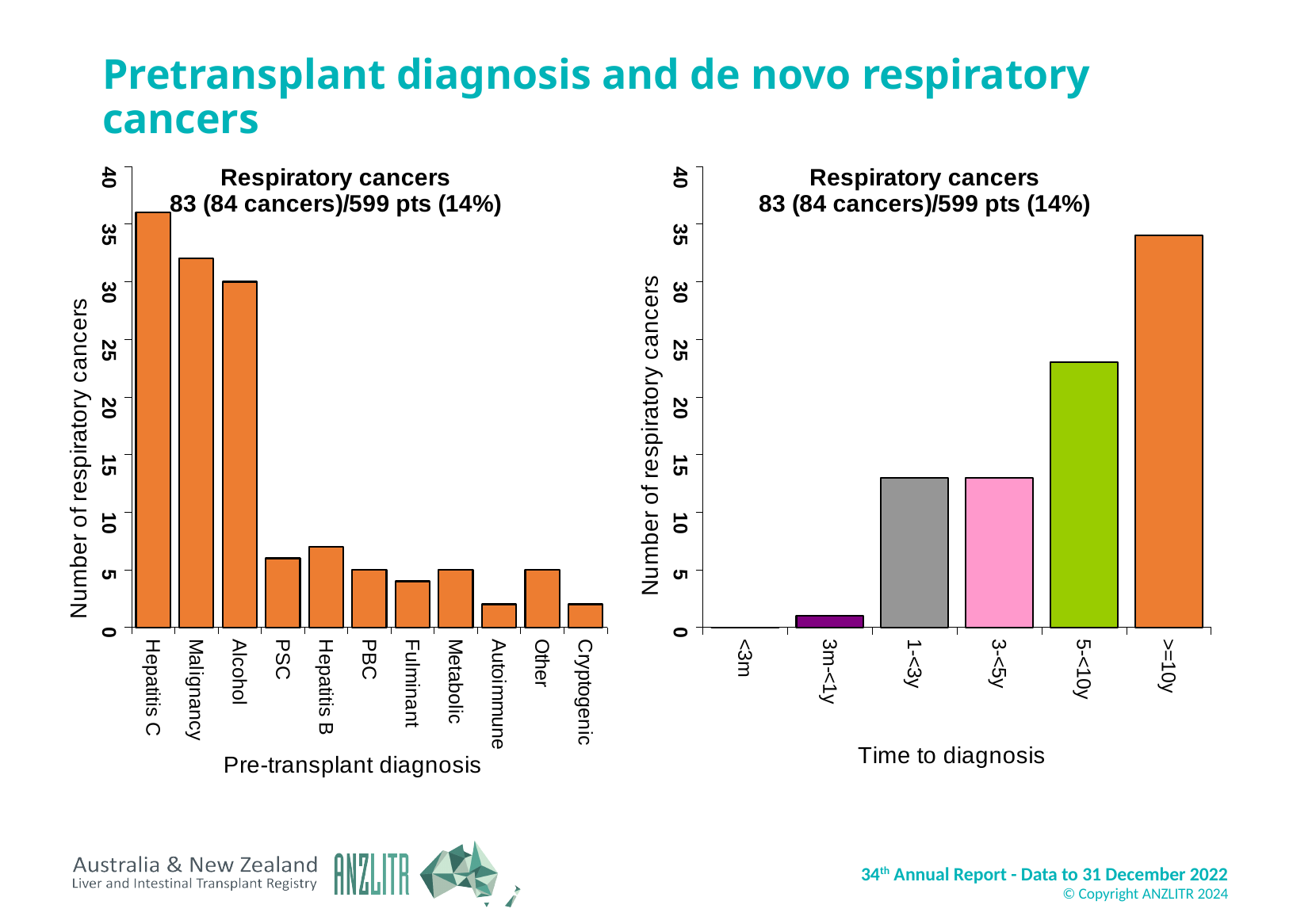
On the left chart (Pre-transplant diagnosis), is the value for PSC greater or less than 10? less What is the x-axis title of the right chart? Time to diagnosis How many time-to-diagnosis categories are shown on the right chart? 6 On the right chart (Time to diagnosis), which category has the highest number of respiratory cancers? >=10y On the right chart (Time to diagnosis), which category has the lowest number of respiratory cancers? <3m How many pre-transplant diagnosis categories are shown on the left chart? 11 On the left chart (Pre-transplant diagnosis), which is larger, Hepatitis C or Malignancy? Hepatitis C On the left chart (Pre-transplant diagnosis), is the value for Hepatitis C greater or less than 35? greater What kind of chart is the left chart (Pre-transplant diagnosis)? Bar chart On the right chart (Time to diagnosis), do the values generally rise or fall as time to diagnosis increases? Rise On the left chart (Pre-transplant diagnosis), which diagnosis has the highest number of respiratory cancers? Hepatitis C On the right chart (Time to diagnosis), is the value for 5-<10y greater or less than 20? greater